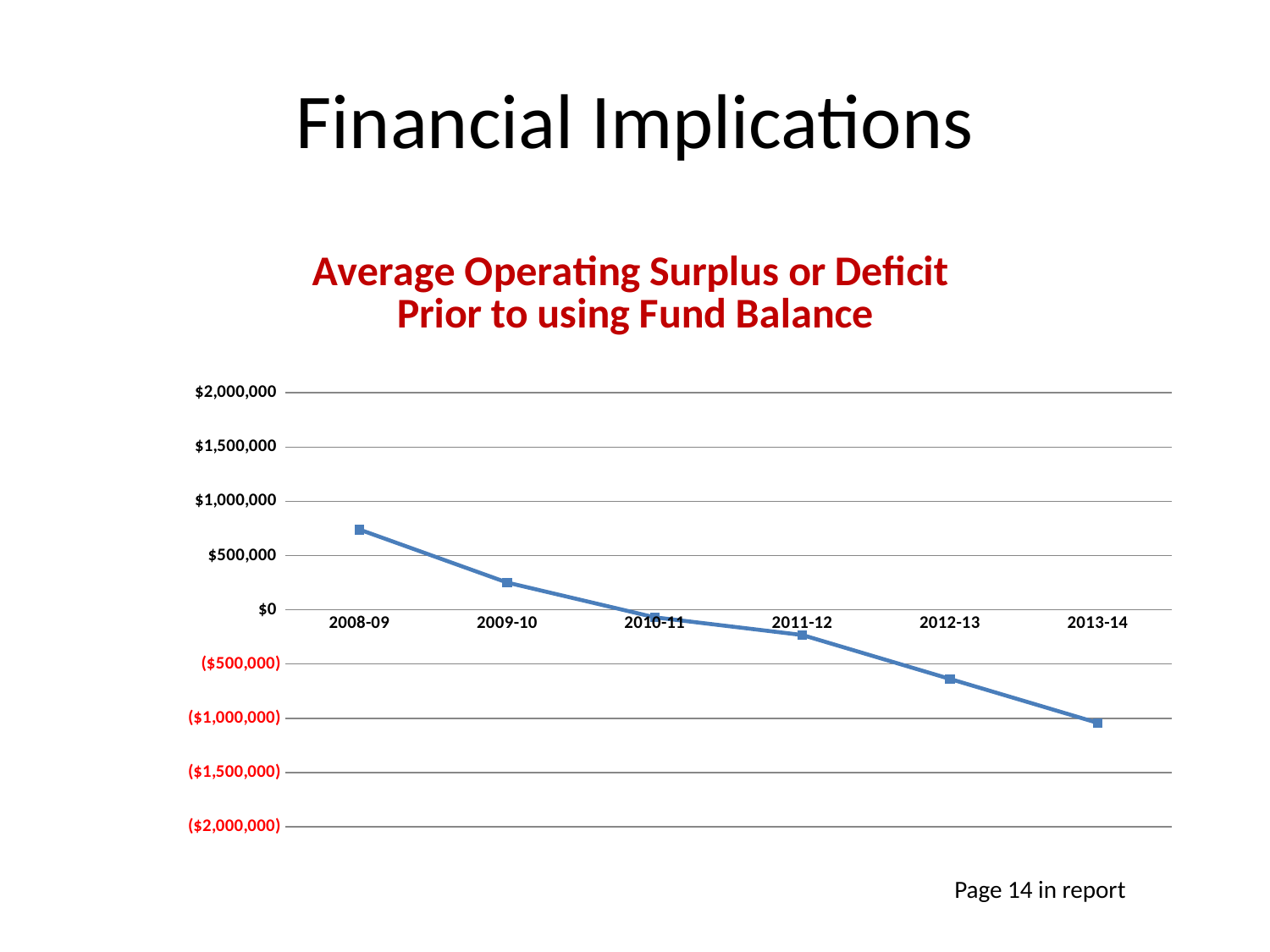
Is the value for 2012-13 greater or less than ($500,000)? less What is the title of the chart? Average Operating Surplus or Deficit Prior to using Fund Balance Is the value for 2009-10 greater or less than $0? greater Do the values rise or fall from 2008-09 to 2013-14? fall What kind of chart is shown on the slide? line chart Is the value for 2009-10 greater or less than $500,000? less How many fiscal years are plotted on the x axis? 6 Which is larger, the value for 2009-10 or the value for 2012-13? 2009-10 Which fiscal year has the highest average operating surplus or deficit? 2008-09 Which fiscal year has the lowest average operating surplus or deficit? 2013-14